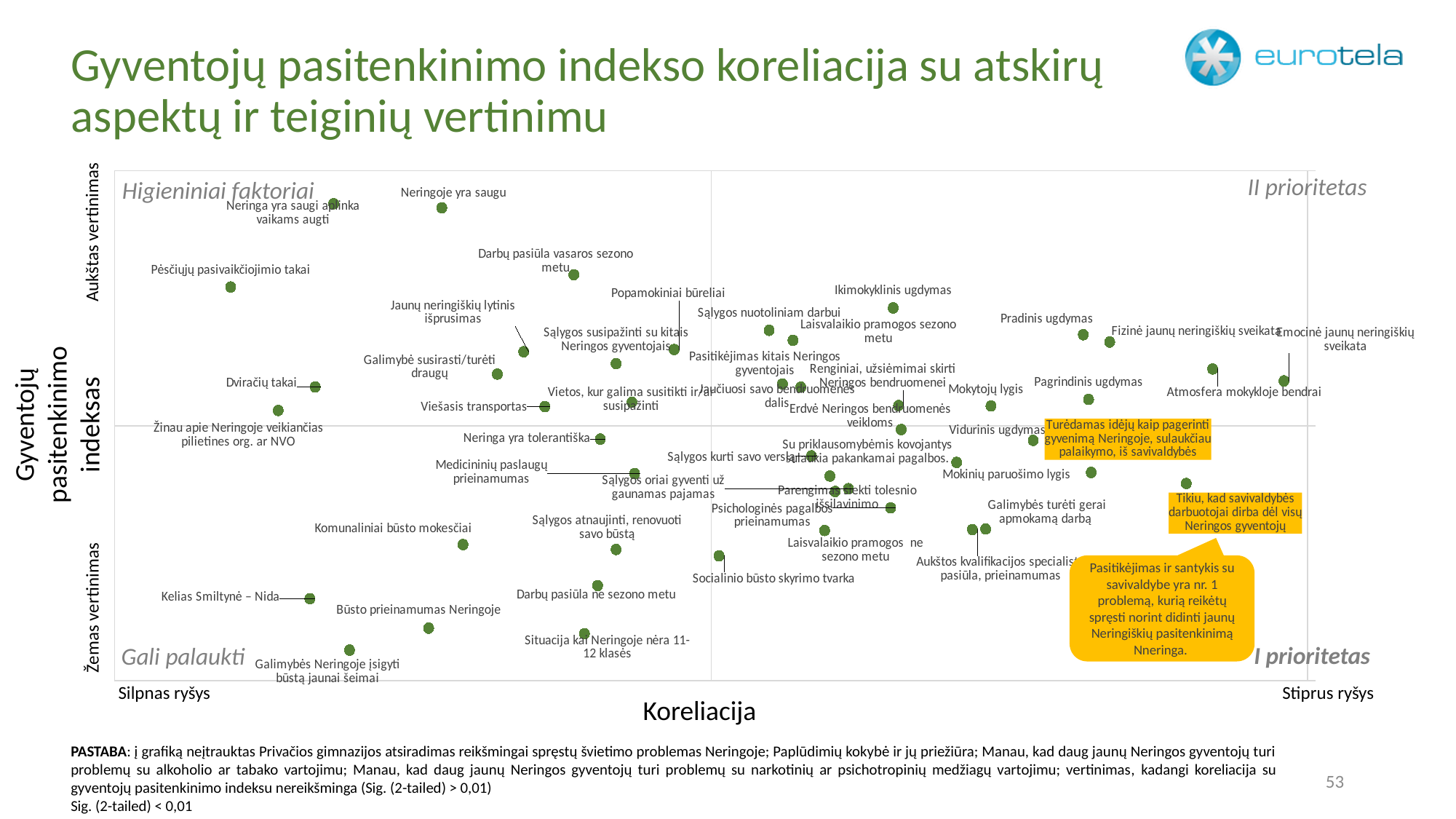
Which point is rated higher on the vertical axis: 'Darbų pasiūla vasaros sezono metu' or 'Darbų pasiūla ne sezono metu'? Darbų pasiūla vasaros sezono metu Which point has a stronger correlation (further right): 'Pradinis ugdymas' or 'Dviračių takai'? Pradinis ugdymas In which quadrant of the chart does the point 'Pradinis ugdymas' fall? II prioritetas What kind of chart is shown on the slide? Scatter chart Which point lies furthest to the right (strongest correlation) on the chart? Emocinė jaunų neringiškių sveikata Which point lies furthest to the left (weakest correlation) on the chart? Pėsčiųjų pasivaikščiojimo takai In which quadrant of the chart does the point 'Kelias Smiltynė – Nida' fall? Gali palaukti In which quadrant of the chart does the point 'Mokinių paruošimo lygis' fall? I prioritetas What is the label of the vertical axis of the chart? Gyventojų pasitenkinimo indeksas What is the label of the horizontal axis of the chart? Koreliacija Which point is lowest on the vertical axis (lowest rating) on the chart? Galimybės Neringoje įsigyti būstą jaunai šeimai Which point is rated higher on the vertical axis: 'Neringoje yra saugu' or 'Kelias Smiltynė – Nida'? Neringoje yra saugu